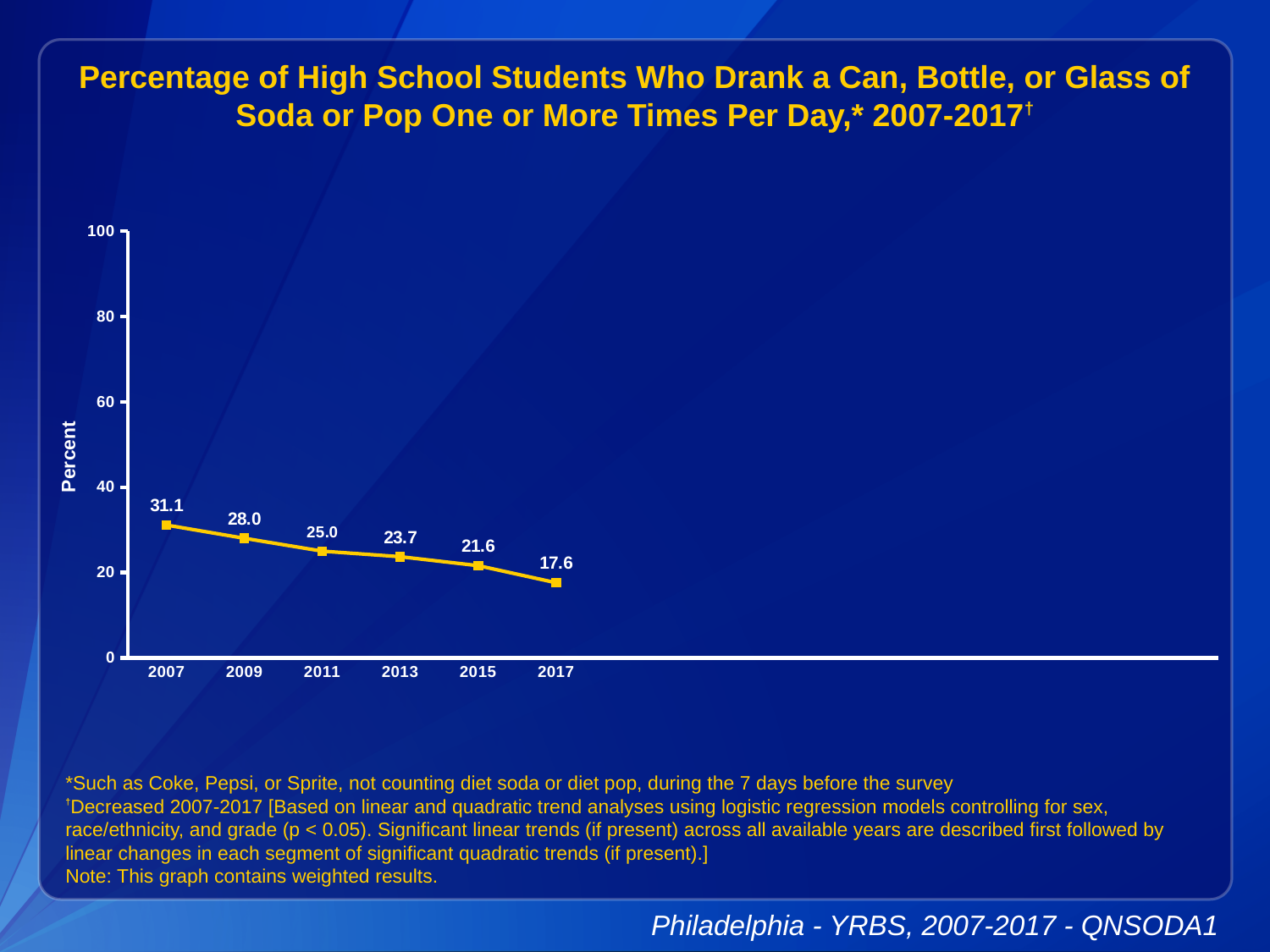
Is the value for 2017 greater or less than 20? less Do the values rise or fall from 2007 to 2017? fall Which is larger, the value for 2009 or the value for 2013? 2009 What is the value plotted for 2017? 17.6 What percentage of high school students drank soda or pop one or more times per day in 2007? 31.1 Which year has the highest percentage? 2007 How many years are plotted on the chart? 6 What is the difference between the 2007 value and the 2017 value? 13.5 What is the value plotted for 2011? 25.0 Which year has the lowest percentage? 2017 What is the difference between the 2013 value and the 2015 value? 2.1 What kind of chart is shown on the slide? line chart